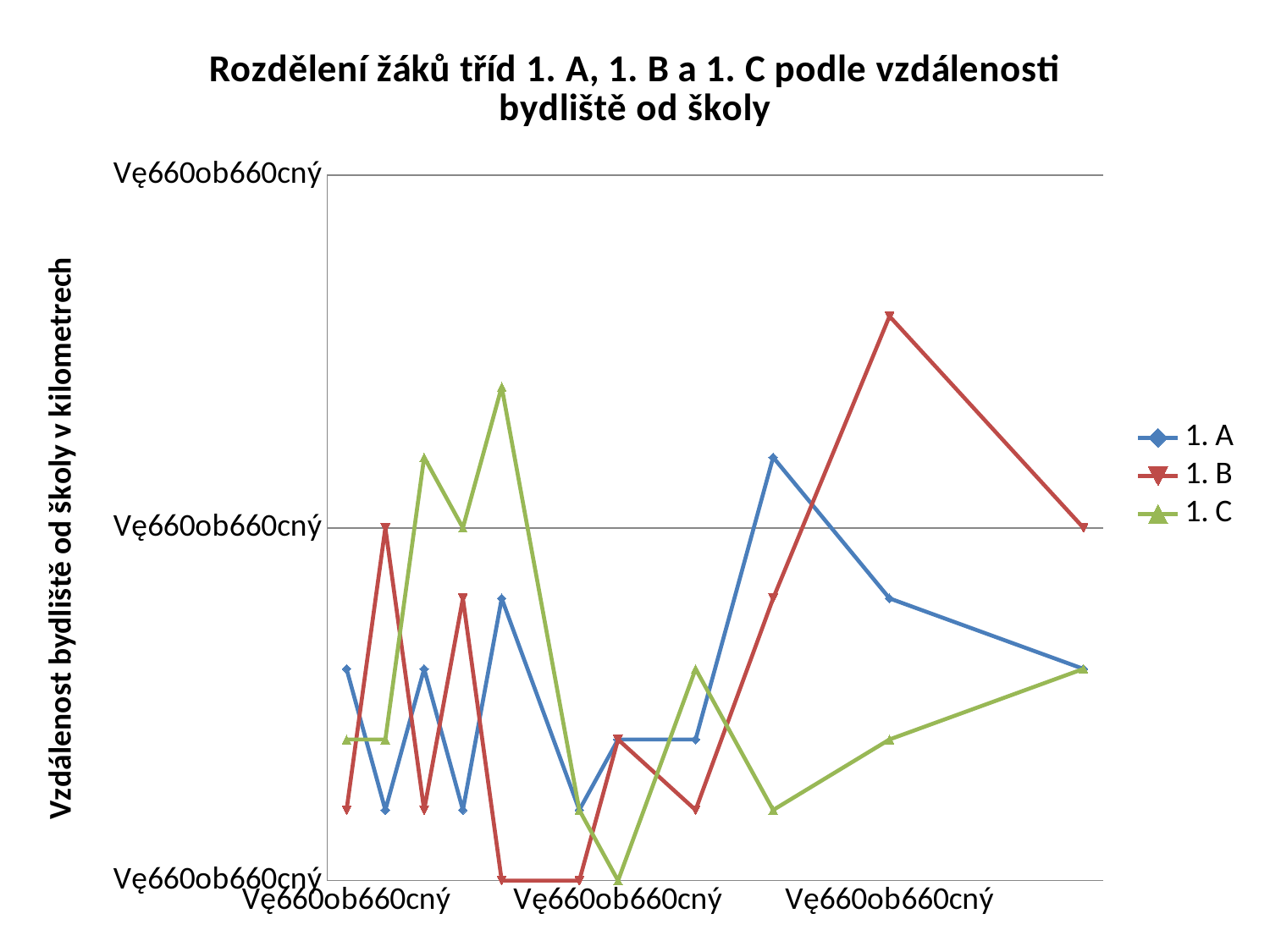
Which series reaches the highest point on the chart? 1. B What kind of chart is shown on the slide? line chart What is the title of the chart? Rozdělení žáků tříd 1. A, 1. B a 1. C podle vzdálenosti bydliště od školy What are the names of the series listed in the legend? 1. A, 1. B, 1. C How many series does the legend list? 3